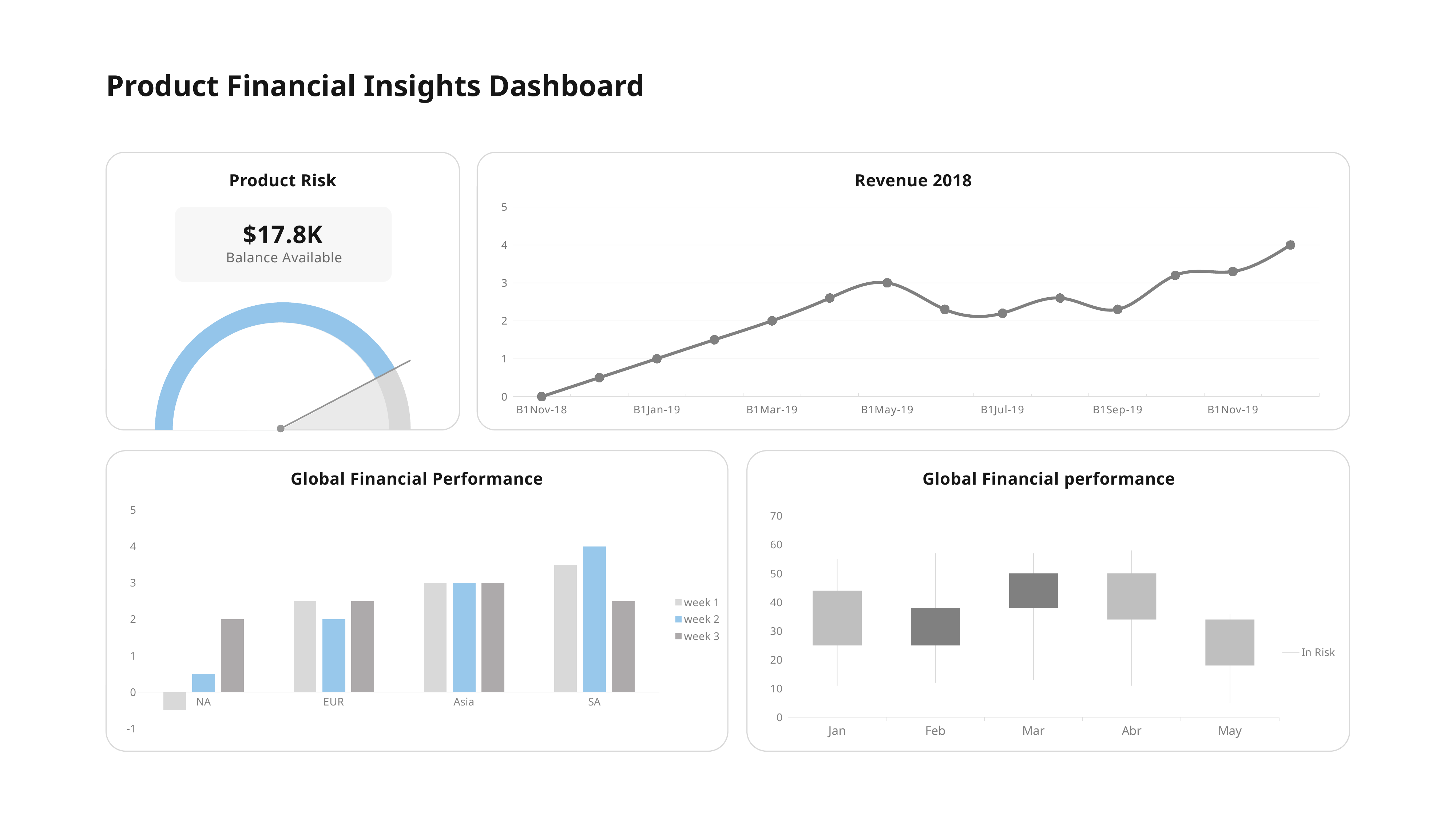
What kind of chart is Revenue 2018? line chart On the Revenue 2018 chart, what is the value at B1May-19? 3 On the Revenue 2018 chart, what is the value at B1Jan-19? 1 On the Global Financial performance chart (bottom right), how many months are shown on the x axis? 5 What balance is shown in the Product Risk panel? $17.8K On the Global Financial Performance bar chart (bottom left), how many series does the legend list? 3 On the Revenue 2018 chart, is the value at B1Nov-19 greater or less than 3? greater On the Global Financial Performance bar chart (bottom left), what is the week 2 value for SA? 4 On the Revenue 2018 chart, is the value at B1Jul-19 greater or less than 3? less On the Revenue 2018 chart, which is larger, the value at B1Mar-19 or the value at B1May-19? B1May-19 On the Global Financial Performance bar chart (bottom left), what is the week 3 value for NA? 2 On the Global Financial Performance bar chart (bottom left), which category has the lowest week 1 value? NA